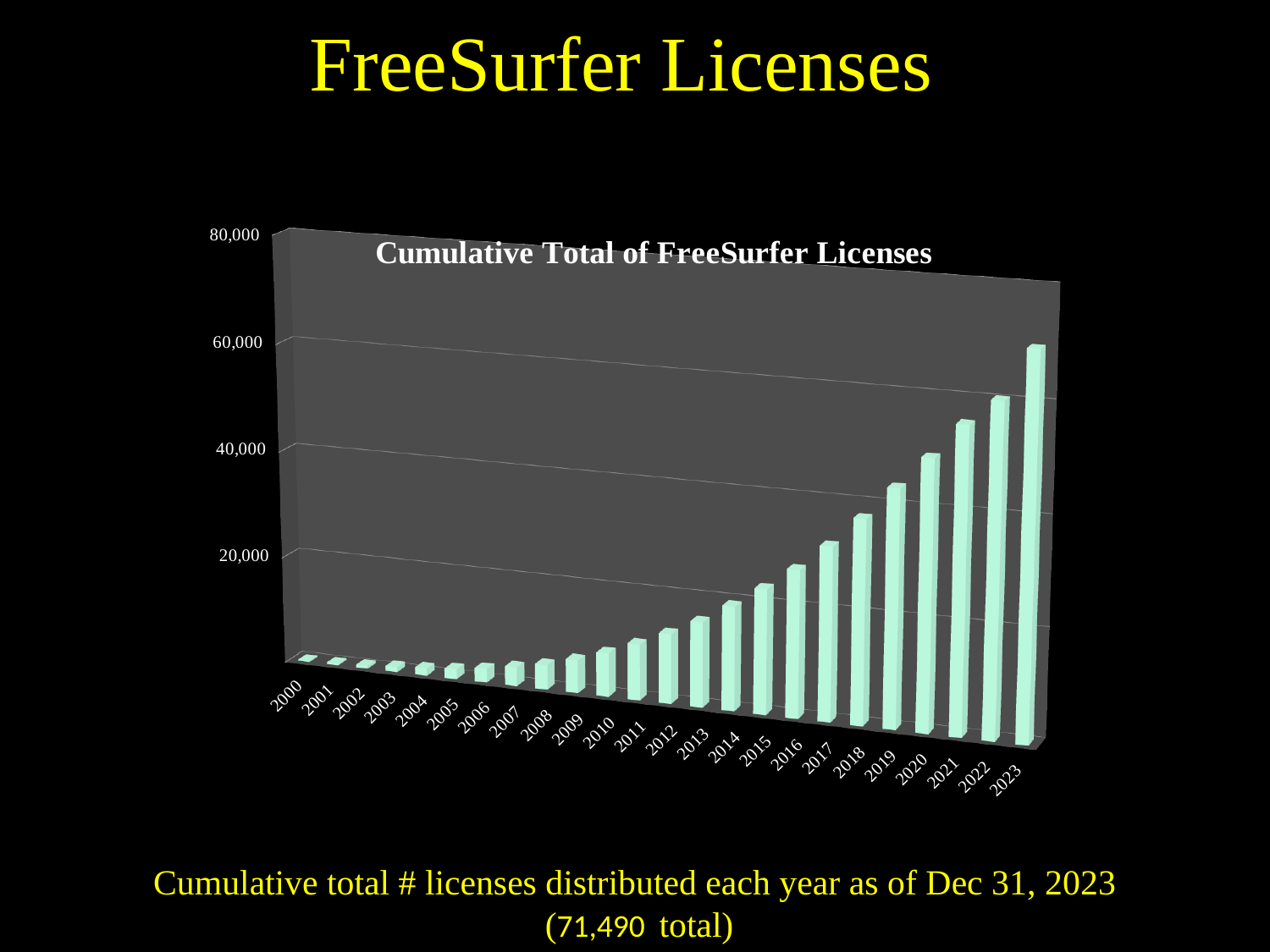
Which year has the highest cumulative total of FreeSurfer licenses? 2023 Which year has a larger value, 2019 or 2012? 2019 Is the value for 2022 greater or less than 40,000? greater Do the values rise or fall from 2000 to 2023? rise Which year has the lowest cumulative total of FreeSurfer licenses? 2000 How many years are shown on the x axis of the chart? 24 What kind of chart is shown on the slide? bar chart Which year has a larger value, 2010 or 2021? 2021 What is the title of the chart? Cumulative Total of FreeSurfer Licenses Is the value for 2018 greater or less than 20,000? greater